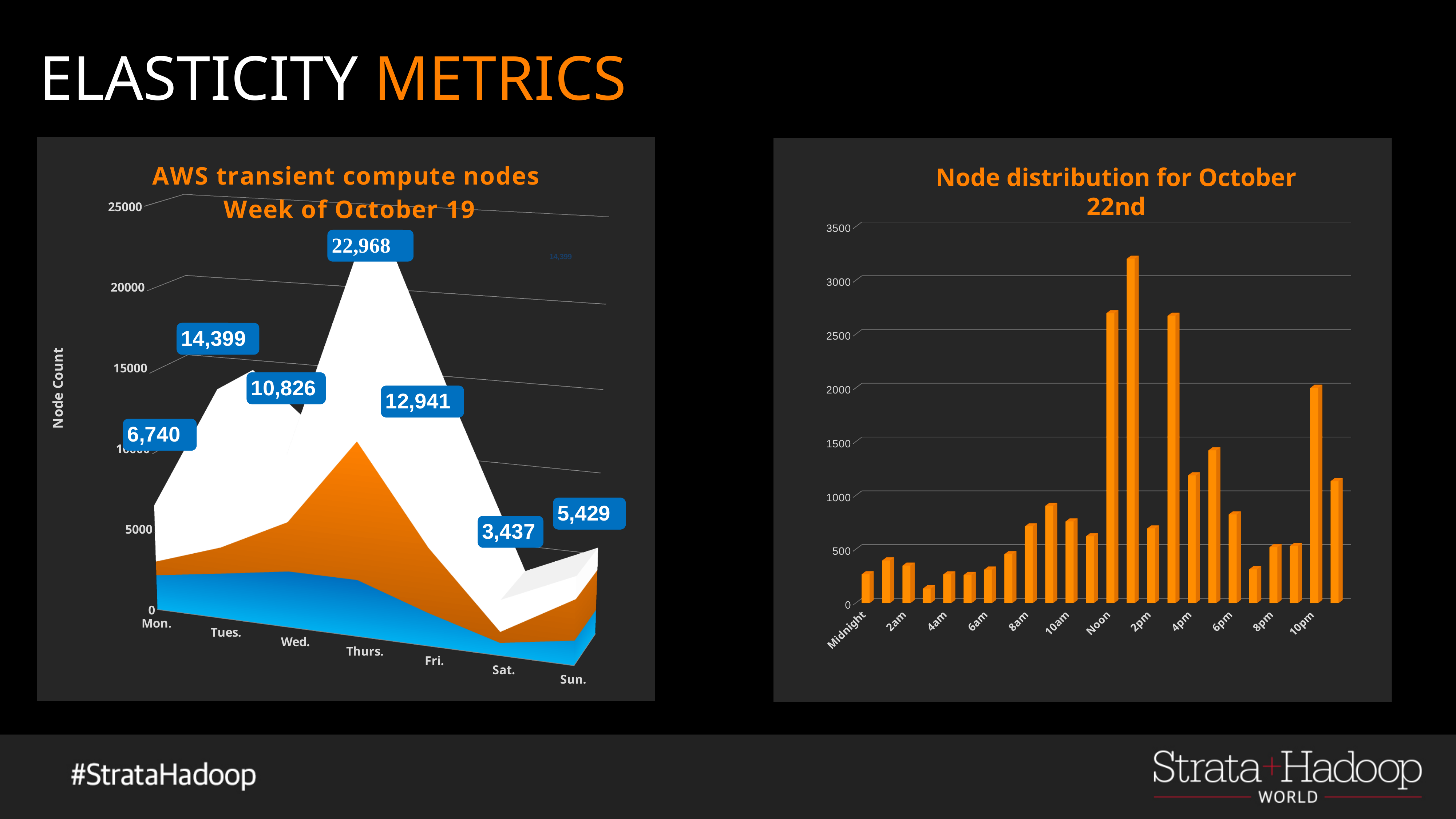
In the 'AWS transient compute nodes Week of October 19' chart, what is the labeled value for Thurs.? 22,968 In the 'Node distribution for October 22nd' chart, is the value for Noon greater or less than 2500? greater How many days are shown on the x axis of the 'AWS transient compute nodes Week of October 19' chart? 7 In the 'AWS transient compute nodes Week of October 19' chart, which day has the lowest labeled value? Sat. In the 'AWS transient compute nodes Week of October 19' chart, which has the larger labeled value, Tues. or Fri.? Tues. What is the title of the vertical axis in the 'AWS transient compute nodes Week of October 19' chart? Node Count In the 'AWS transient compute nodes Week of October 19' chart, what is the labeled value for Mon.? 6,740 In the 'AWS transient compute nodes Week of October 19' chart, which day has the highest labeled value? Thurs. In the 'Node distribution for October 22nd' chart, is the value for 4am greater or less than 500? less In the 'Node distribution for October 22nd' chart, which is larger, the value for Noon or the value for 6am? Noon In the 'AWS transient compute nodes Week of October 19' chart, what is the difference between the labeled values for Thurs. and Tues.? 8,569 What kind of chart is 'Node distribution for October 22nd'? bar chart